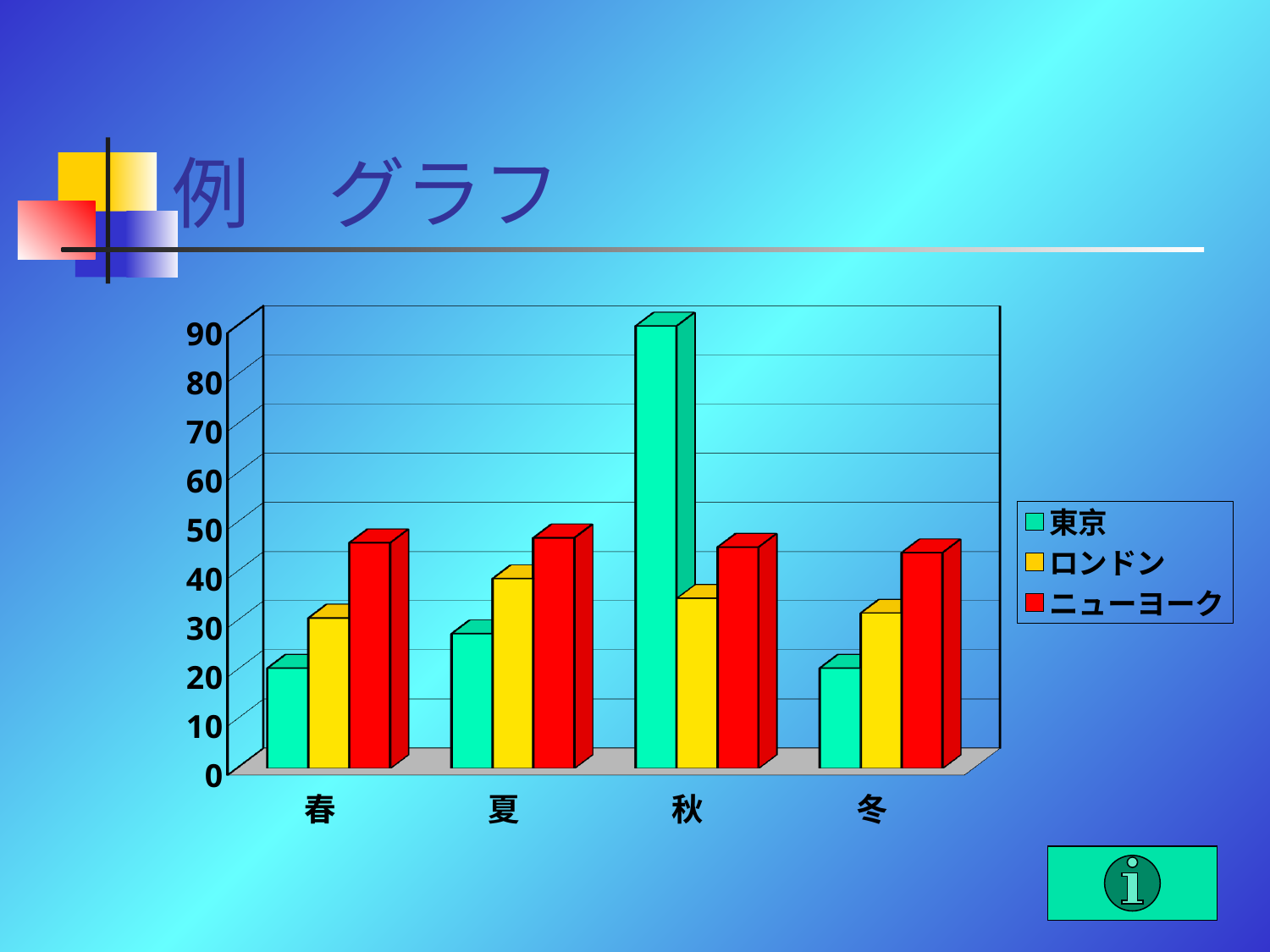
What colour represents ニューヨーク in the chart? red What kind of chart is shown on the slide? bar chart Is the value for 東京 in 秋 greater or less than 80? greater How many categories are shown on the x axis? 4 In 秋, which is larger: the value for 東京 or the value for ニューヨーク? 東京 In 夏, which is larger: the value for ロンドン or the value for 東京? ロンドン Is the value for 東京 in 春 greater or less than 30? less Which season has the highest value for 東京? 秋 Is the value for ニューヨーク in 春 greater or less than 40? greater What are the entries listed in the legend? 東京, ロンドン, ニューヨーク How many series does the legend list? 3